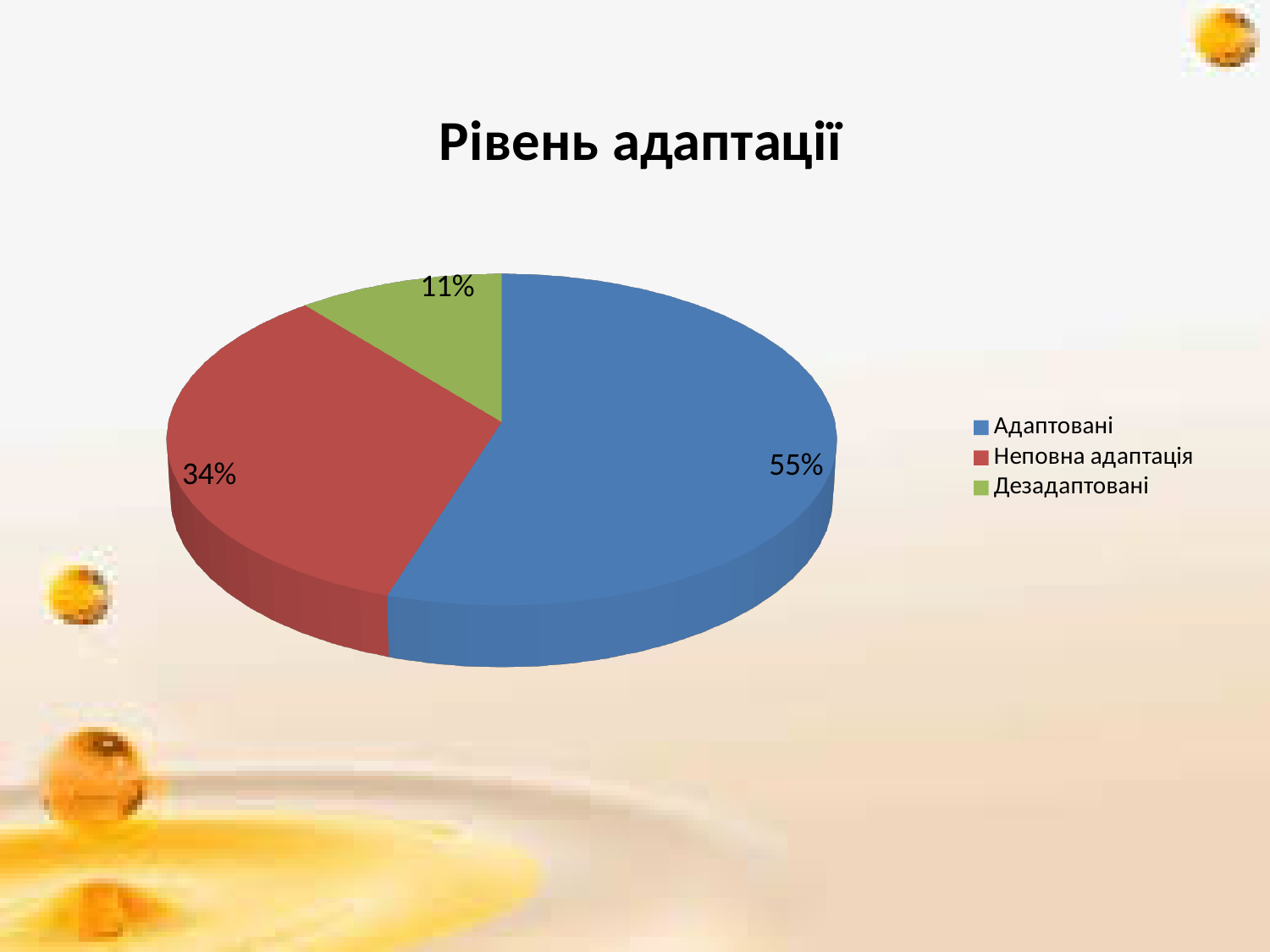
What type of chart is shown on the slide? pie chart Which category has the smallest slice of the pie? Дезадаптовані What is the difference in percentage points between Адаптовані and Неповна адаптація? 21 What colour is the slice for Дезадаптовані? green What share of the pie is labelled Адаптовані? 55% What share of the pie is labelled Дезадаптовані? 11% What is the difference in percentage points between Неповна адаптація and Дезадаптовані? 23 What share of the pie is labelled Неповна адаптація? 34% Which category has the largest slice of the pie? Адаптовані Which is larger, the share for Неповна адаптація or the share for Дезадаптовані? Неповна адаптація How many categories does the pie chart have? 3 What is the title of the chart? Рівень адаптації